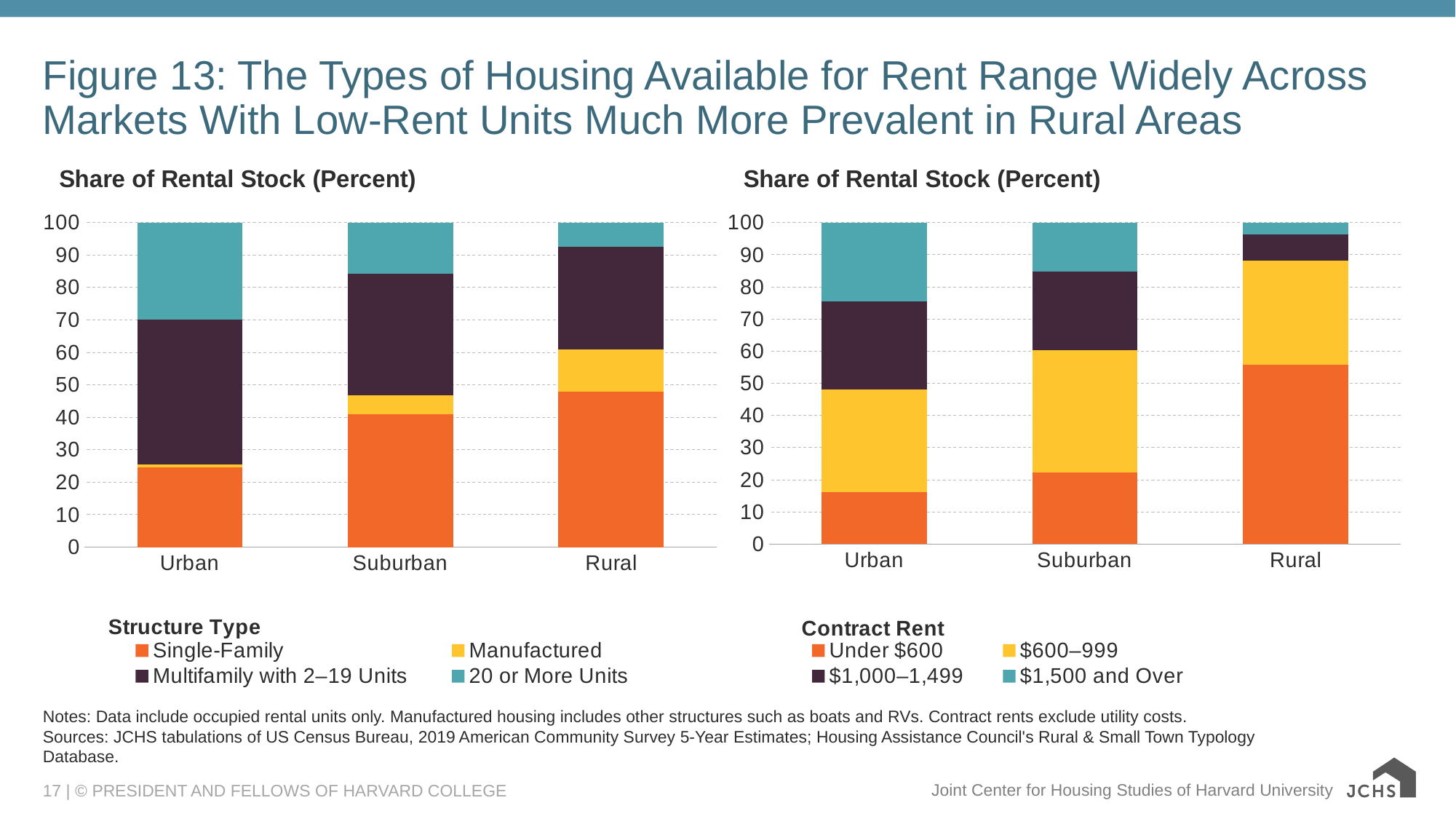
In the right chart (Contract Rent), which category has the largest Under $600 share? Rural In the left chart (Structure Type), which category has the largest 20 or More Units share? Urban In the right chart (Contract Rent), is the Under $600 share for Rural greater or less than 50? greater What is the legend title of the right chart? Contract Rent How many categories are shown on the x axis of the left chart (Structure Type)? 3 In the right chart (Contract Rent), which category has the smallest $1,500 and Over share? Rural How many series does the legend of the right chart (Contract Rent) list? 4 In the left chart (Structure Type), is the Single-Family share for Rural greater or less than 40? greater In the left chart (Structure Type), does the Single-Family share rise or fall moving from Urban to Suburban to Rural? rise In the left chart (Structure Type), is the Single-Family share for Urban greater or less than 30? less What kind of chart is the left chart (Structure Type)? stacked bar chart In the right chart (Contract Rent), is the Under $600 share larger for Urban or for Suburban? Suburban